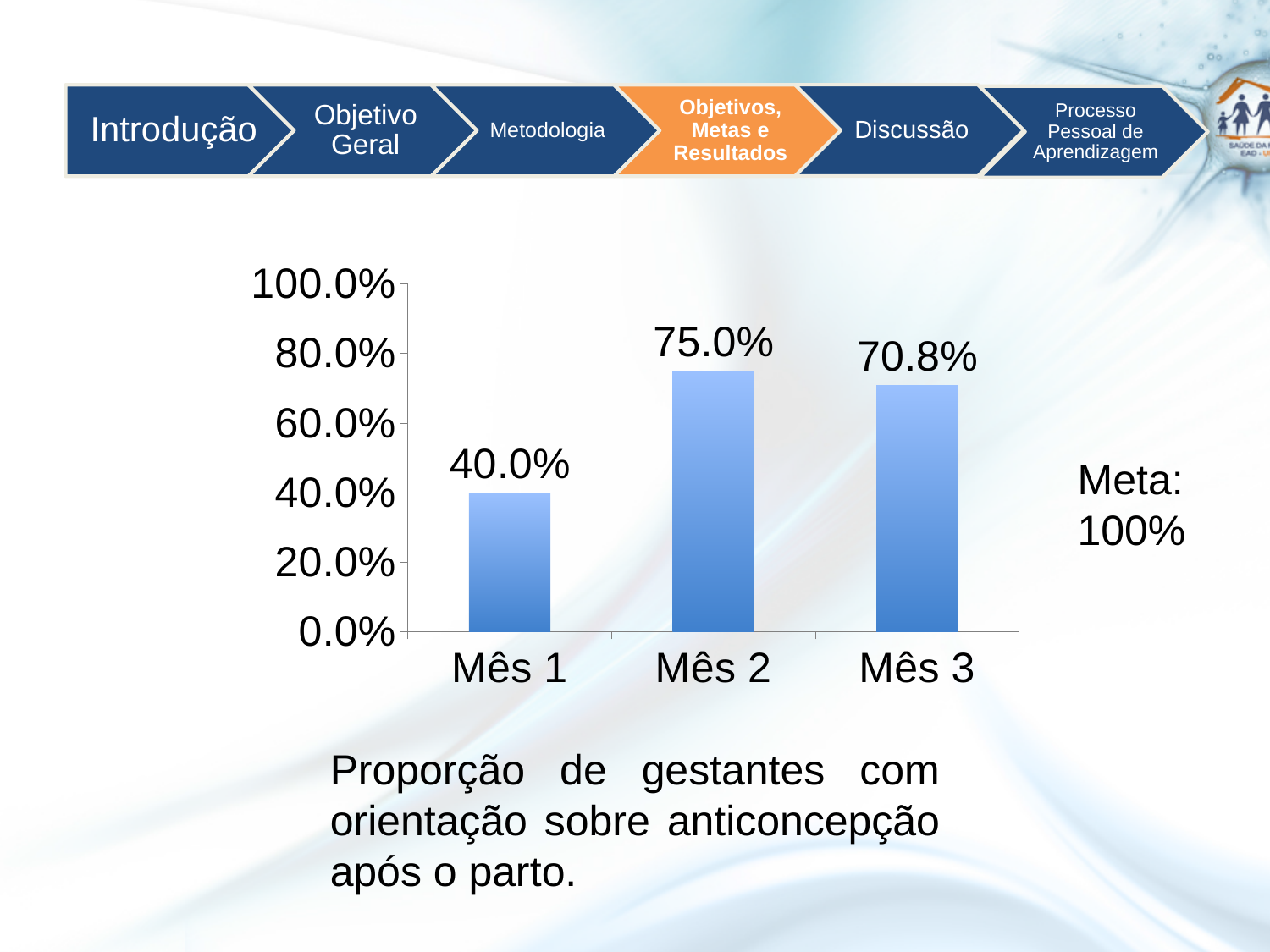
What kind of chart is shown on the slide? bar chart What is the value for Mês 1? 40.0% Which month has the lowest value? Mês 1 How many months are shown on the x axis? 3 Which month has the highest value? Mês 2 Which is larger, the value for Mês 1 or the value for Mês 3? Mês 3 What is the target (Meta) stated next to the chart? 100% What is the difference between the values for Mês 2 and Mês 1? 35.0% What is the value for Mês 3? 70.8% What is the value for Mês 2? 75.0% What is the difference between the values for Mês 2 and Mês 3? 4.2% Is the value for Mês 3 greater or less than 60.0%? greater